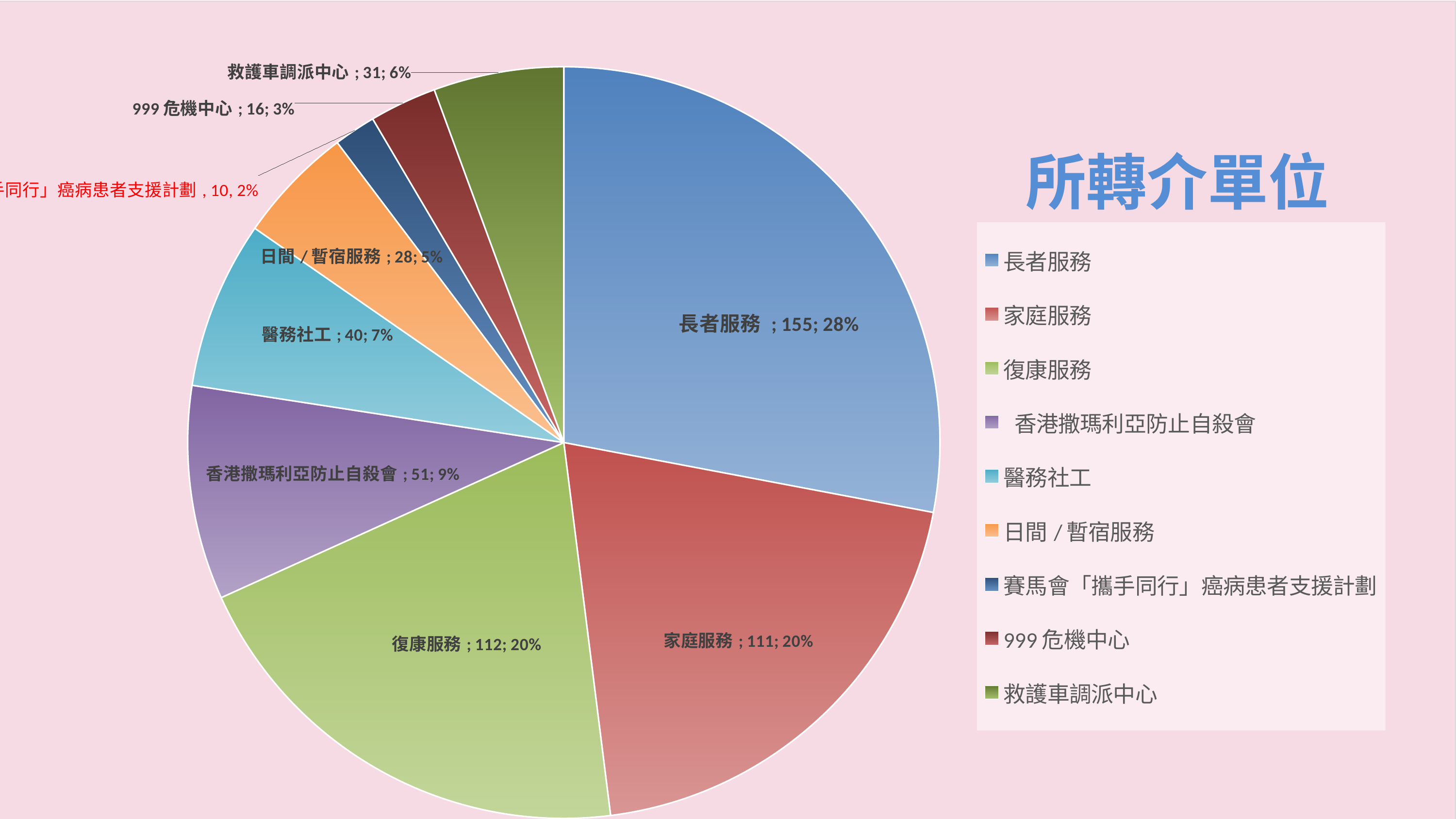
What is the difference between the values for 長者服務 and 復康服務? 43 Which category has the smallest slice? 賽馬會「攜手同行」癌病患者支援計劃 What is the value for 醫務社工? 40 What is the value for 救護車調派中心? 31 What percentage share does 999 危機中心 have? 3% What is the value for 長者服務? 155 Which is larger, the value for 香港撒瑪利亞防止自殺會 or the value for 醫務社工? 香港撒瑪利亞防止自殺會 Which category has the largest slice? 長者服務 How many categories does the legend list? 9 What is the title of the chart? 所轉介單位 What kind of chart is shown on the slide? pie chart What percentage share does 家庭服務 have? 20%